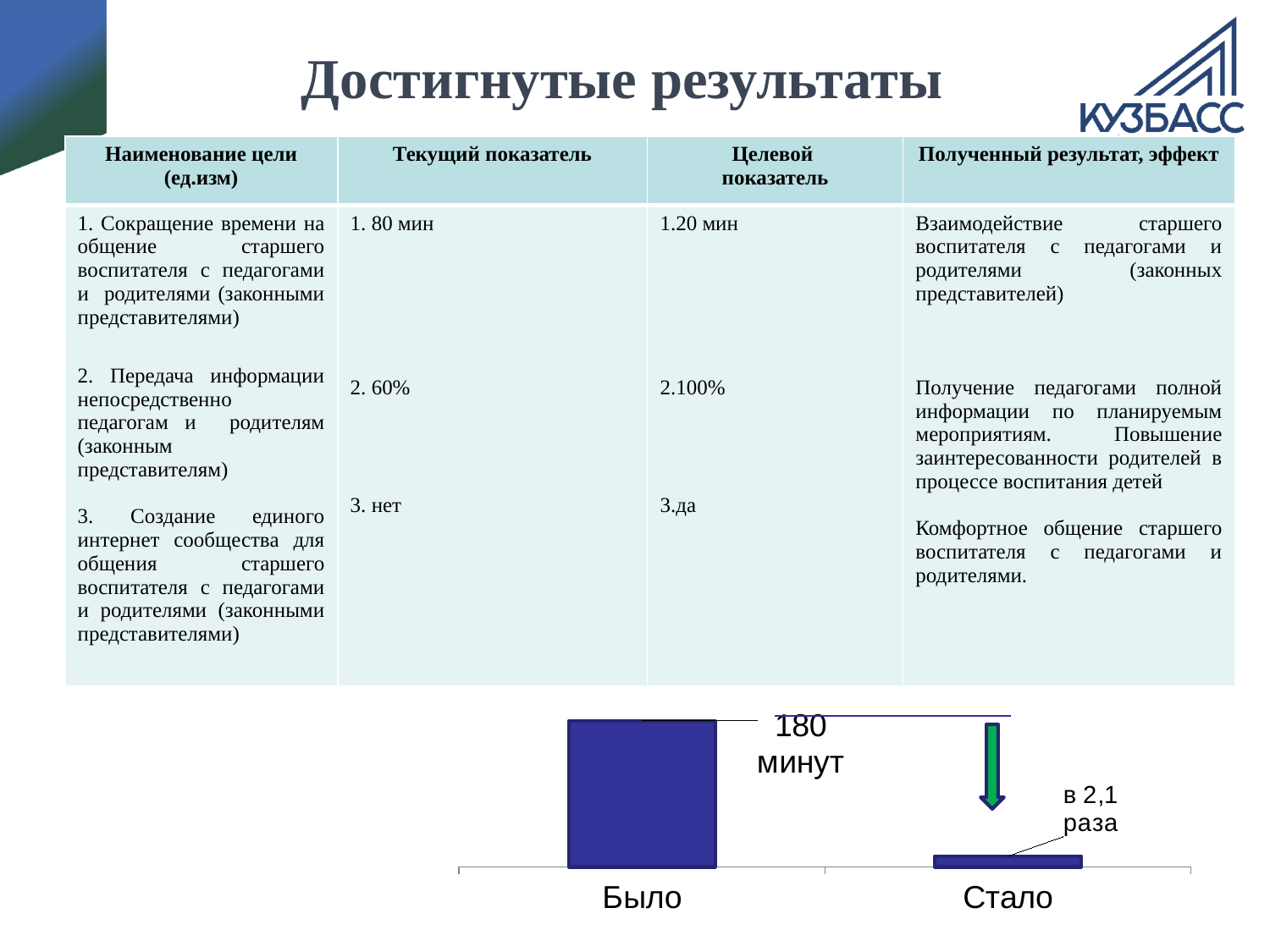
In the bar chart, which is larger: Было or Стало? Было What are the two category labels on the x axis of the bar chart? Было, Стало What value is labelled on the Было bar in the chart? 180 минут Which category in the bar chart has the highest value? Было Do the values in the bar chart rise or fall from Было to Стало? fall How many categories does the bar chart at the bottom of the slide have? 2 What annotation is attached to the Стало bar in the chart? в 2,1 раза What kind of chart is shown at the bottom of the slide? bar chart Which category in the bar chart has the lowest value? Стало